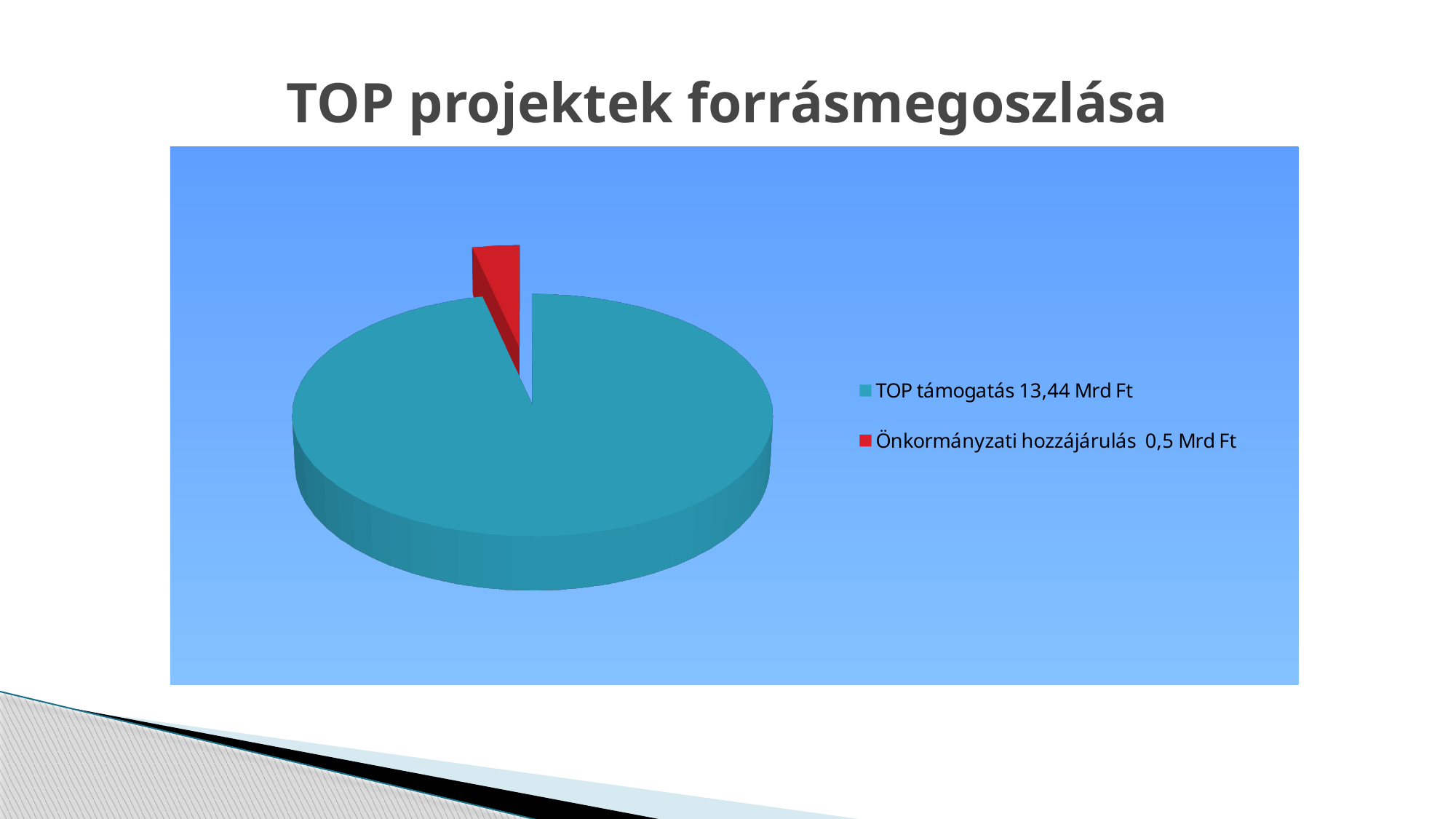
How many entries does the legend list? 2 What colour is the Önkormányzati hozzájárulás slice? Red Which category has the smallest slice of the pie? Önkormányzati hozzájárulás What is the value for Önkormányzati hozzájárulás? 0,5 Mrd Ft What is the total of the two values shown in the legend? 13,94 Mrd Ft How many slices does the pie chart have? 2 What is the title of the slide? TOP projektek forrásmegoszlása Which is larger, TOP támogatás or Önkormányzati hozzájárulás? TOP támogatás What kind of chart is shown on the slide? Pie chart Which category has the largest slice of the pie? TOP támogatás What is the value for TOP támogatás? 13,44 Mrd Ft What is the difference between TOP támogatás and Önkormányzati hozzájárulás? 12,94 Mrd Ft